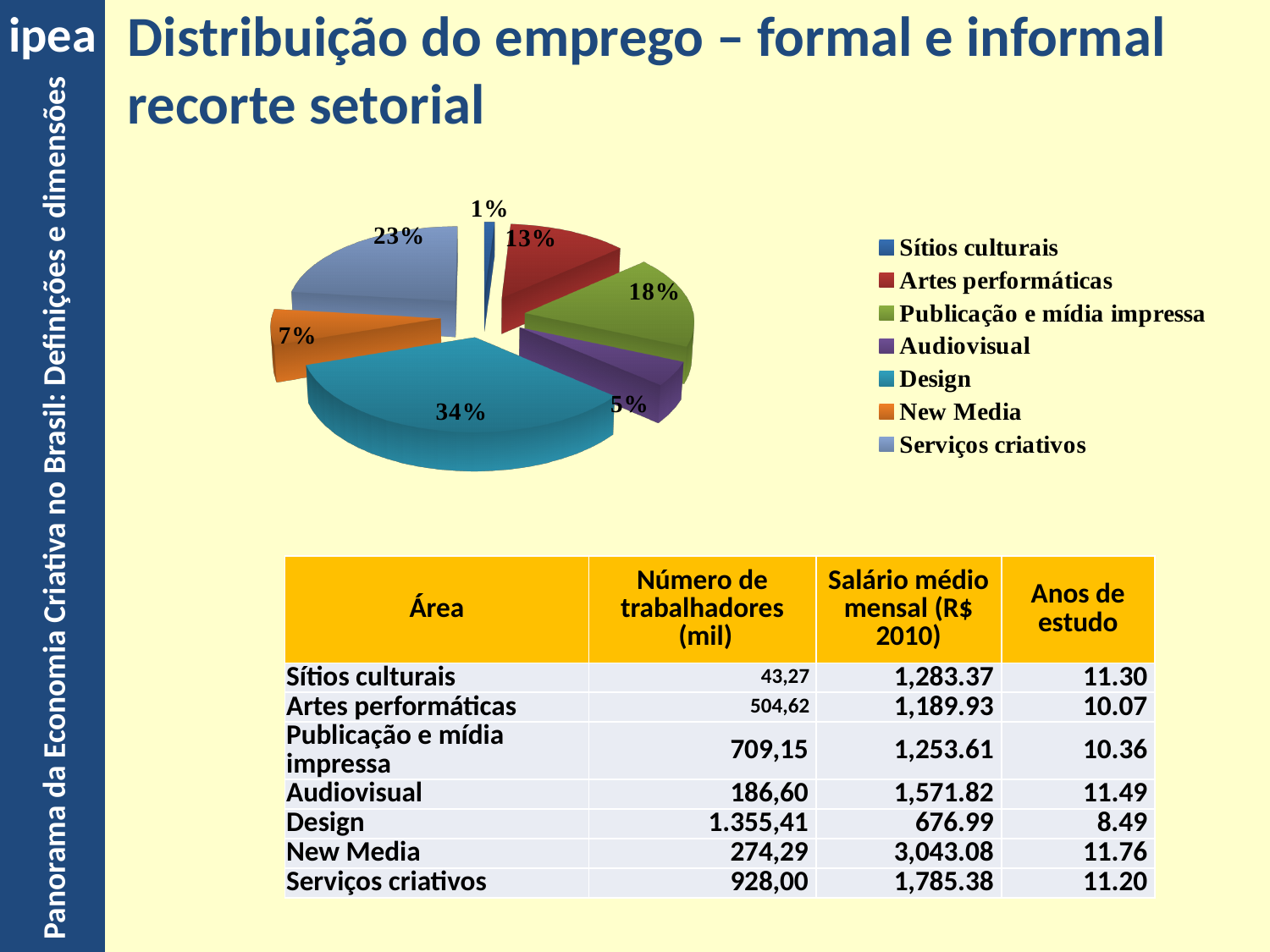
Which category has the smallest slice of the pie? Sítios culturais What share of the pie does Artes performáticas hold? 13% What share of the pie does Serviços criativos hold? 23% What is the difference in percentage points between the Design slice and the Serviços criativos slice? 11 What share of the pie does New Media hold? 7% How many categories does the pie chart legend list? 7 What kind of chart is shown on the slide? Pie chart Which category has the largest slice of the pie? Design Which slice is larger, Audiovisual or New Media? New Media Which colour represents Design in the pie chart? Teal (blue-green)